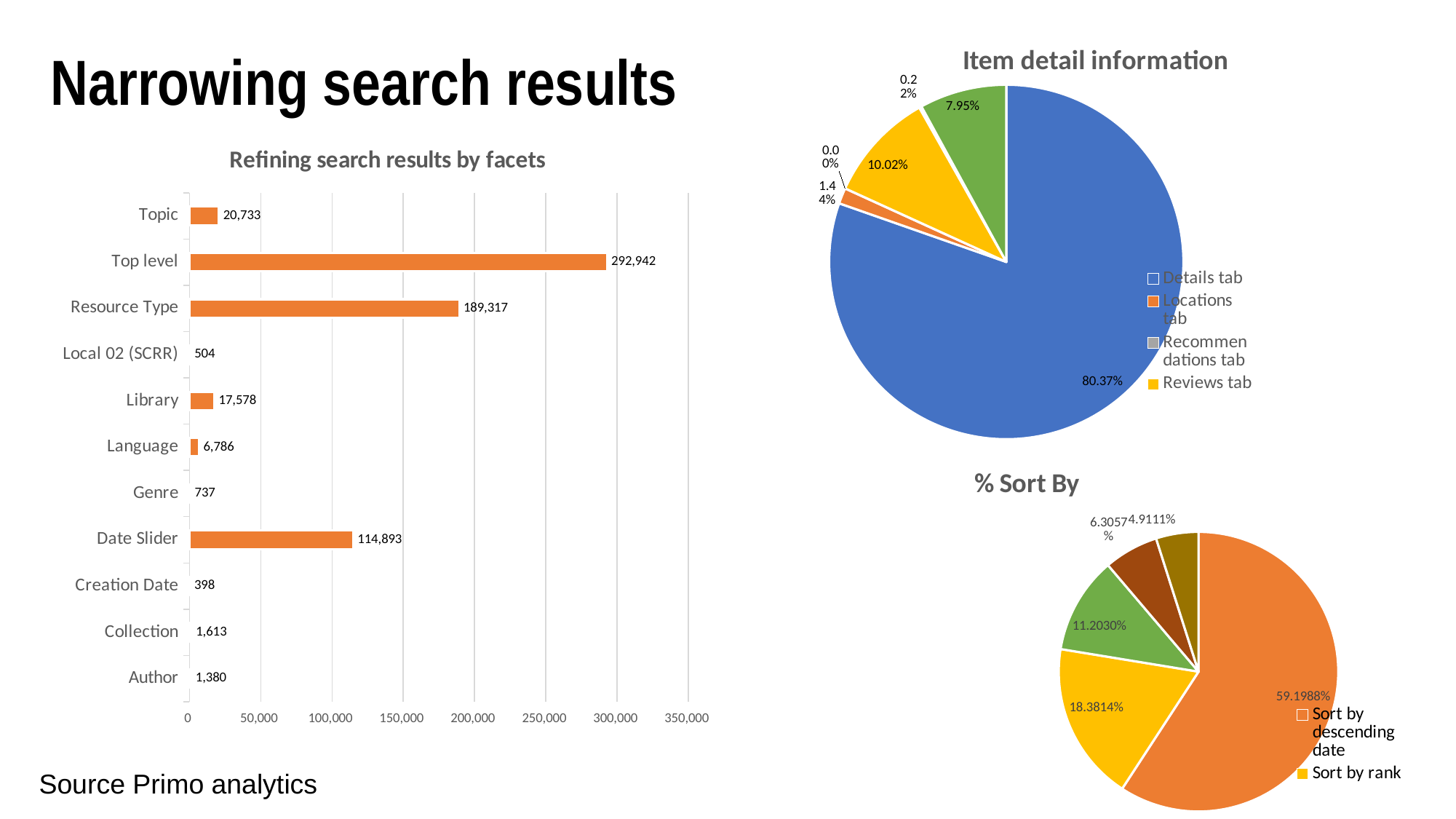
In the "Refining search results by facets" chart, what is the value for Language? 6,786 In the "Refining search results by facets" chart, which facet has the highest value? Top level In the "Item detail information" pie chart, what share does the Details tab have? 80.37% What kind of chart is "Refining search results by facets"? bar chart In the "Item detail information" pie chart, what share does the Reviews tab have? 10.02% In the "Refining search results by facets" chart, which facet has the lowest value? Creation Date In the "Refining search results by facets" chart, which is larger, Date Slider or Library? Date Slider In the "% Sort By" pie chart, what share does "Sort by descending date" have? 59.1988% In the "Refining search results by facets" chart, is the value for Date Slider greater or less than 100,000? greater How many facets are shown in the "Refining search results by facets" chart? 11 In the "Refining search results by facets" chart, what is the value for Top level? 292,942 In the "Refining search results by facets" chart, what is the difference between Top level and Resource Type? 103,625